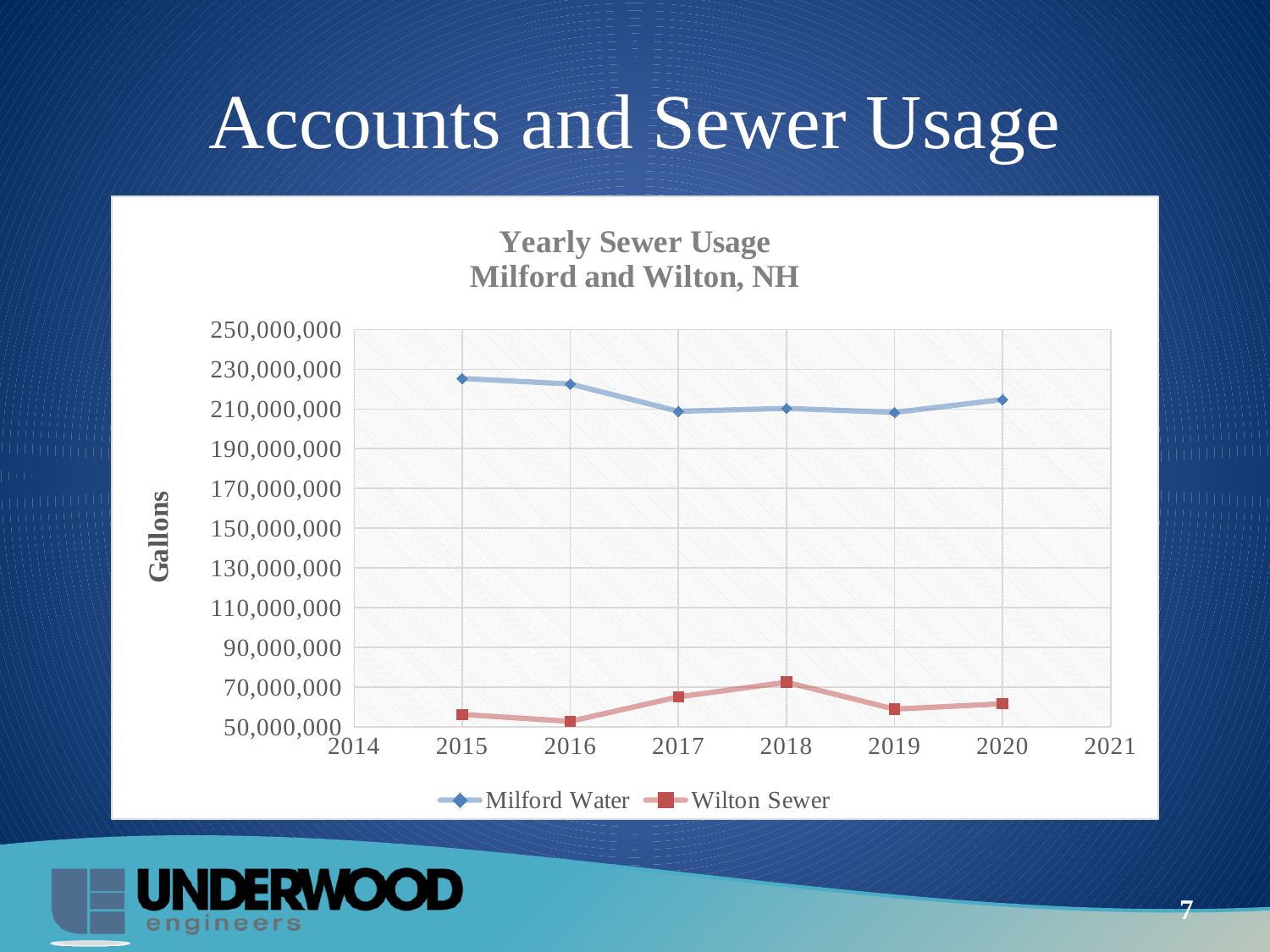
In which year is Milford Water usage highest? 2015 What kind of chart is shown on the slide? line chart Is the Milford Water value for 2015 greater or less than 210,000,000? greater In which year is Wilton Sewer usage highest? 2018 Is the Wilton Sewer value for 2018 greater or less than 70,000,000? greater How many data points are plotted for the Milford Water series? 6 Is the Wilton Sewer value for 2016 greater or less than 70,000,000? less Which series has the larger value in 2019, Milford Water or Wilton Sewer? Milford Water How many series does the legend list? 2 What is the label on the vertical axis? Gallons Does Milford Water usage rise or fall from 2015 to 2017? fall In which year is Wilton Sewer usage lowest? 2016